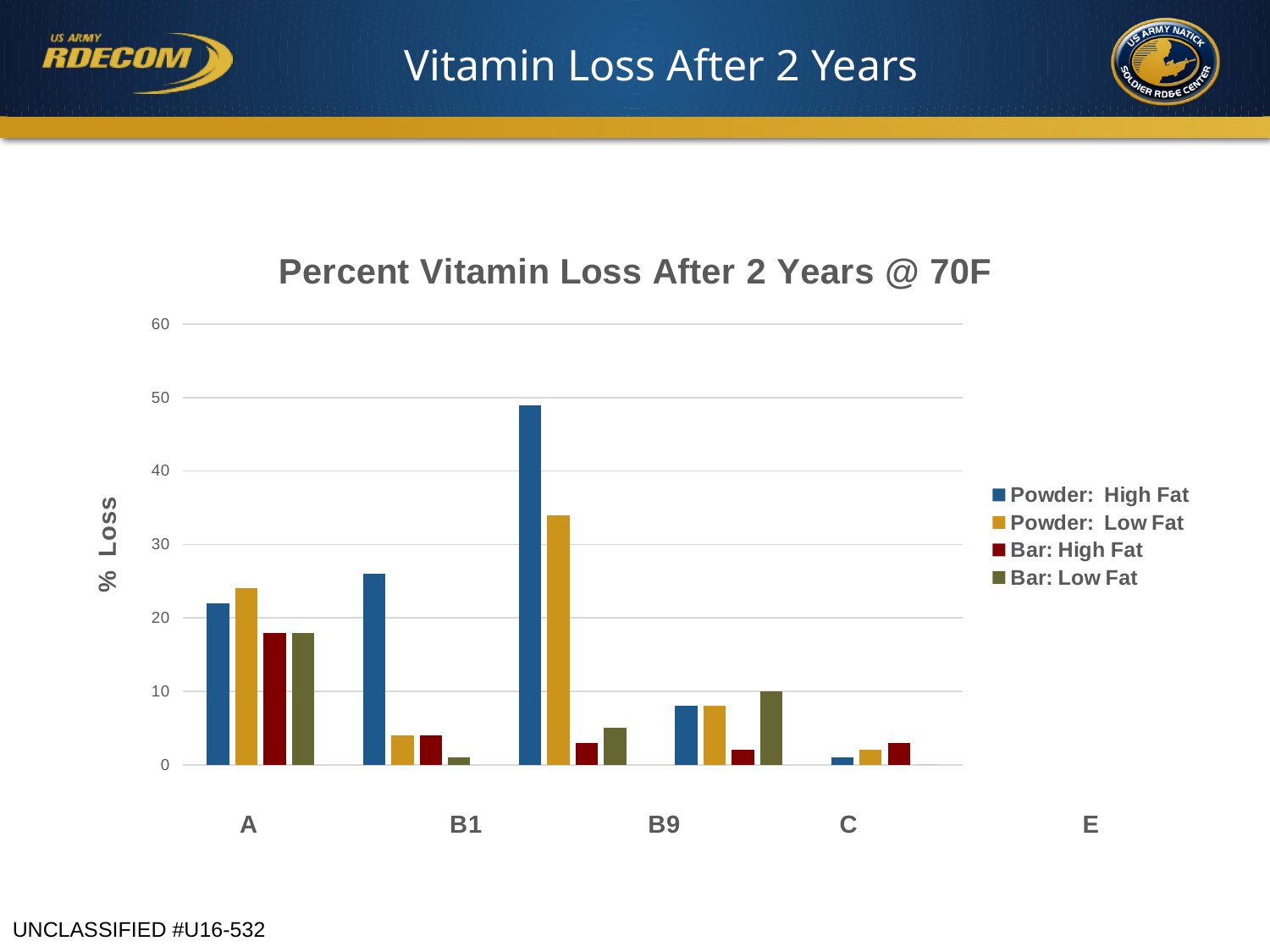
For which vitamin is the Bar: Low Fat loss highest? A Is the Powder: Low Fat value for B9 greater or less than 30? greater For B9, which is larger: Bar: High Fat or Bar: Low Fat? Bar: Low Fat Is the Bar: Low Fat value for B1 greater or less than 10? less Is the Powder: High Fat value for B9 greater or less than 40? greater How many vitamin categories are shown on the x axis? 5 For which vitamin is the Powder: High Fat loss highest? B9 How many series does the legend list? 4 What is the title of the chart? Percent Vitamin Loss After 2 Years @ 70F For B1, which is larger: Powder: High Fat or Powder: Low Fat? Powder: High Fat What kind of chart is shown on the slide? Bar chart What is the label on the y axis? % Loss